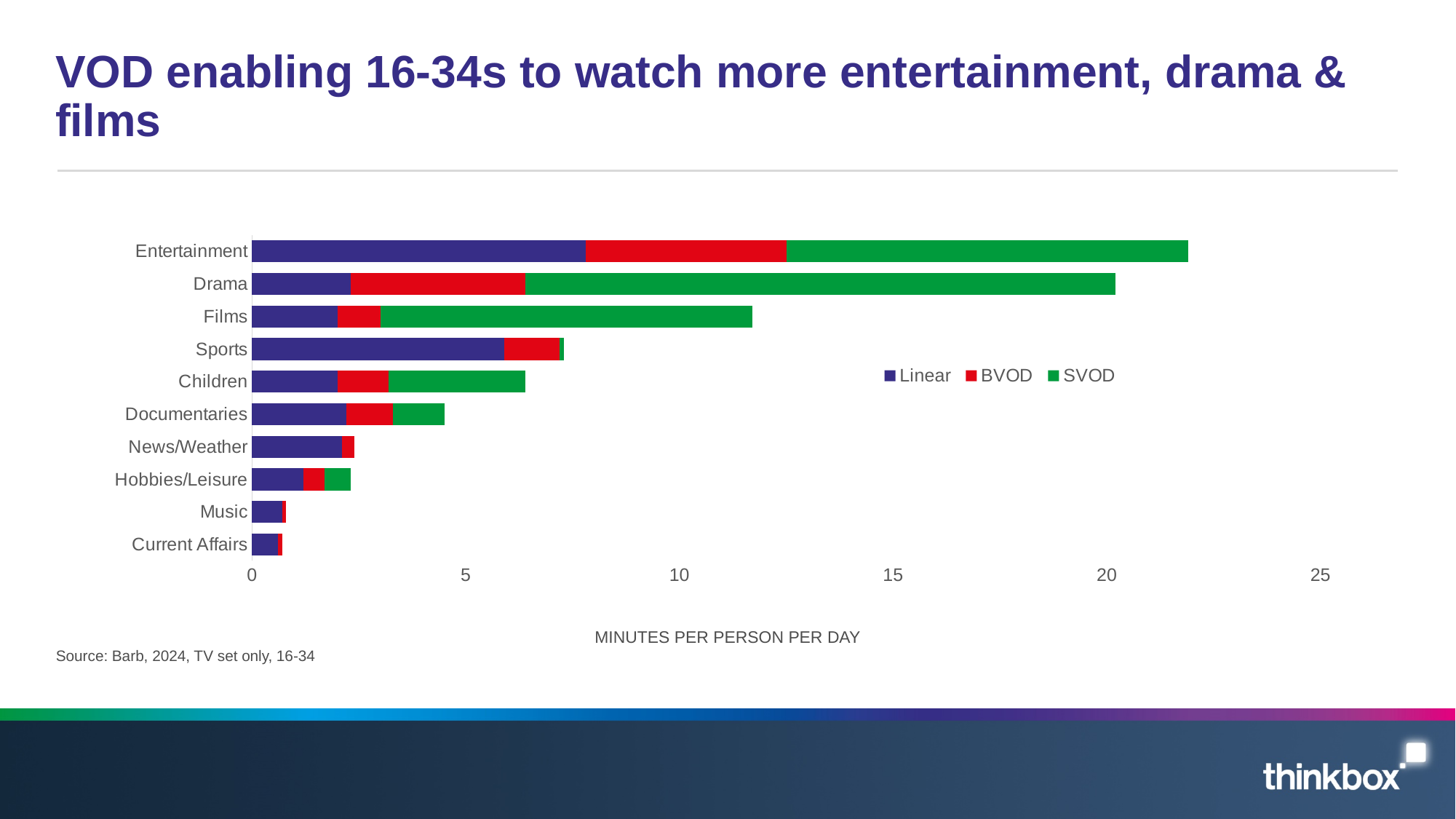
Which category has the highest total minutes per person per day? Entertainment Which has a larger total, Films or Sports? Films What are the three series named in the legend? Linear, BVOD, SVOD Is the total value for Sports greater or less than 5? greater What kind of chart is shown on the slide? Stacked bar chart How many series does the legend list? 3 How many categories are plotted on the chart? 10 Is the total value for Documentaries greater or less than 5? less What is the label on the horizontal axis of the chart? MINUTES PER PERSON PER DAY Is the total value for Entertainment greater or less than 20? greater Which has a larger total, Children or Documentaries? Children